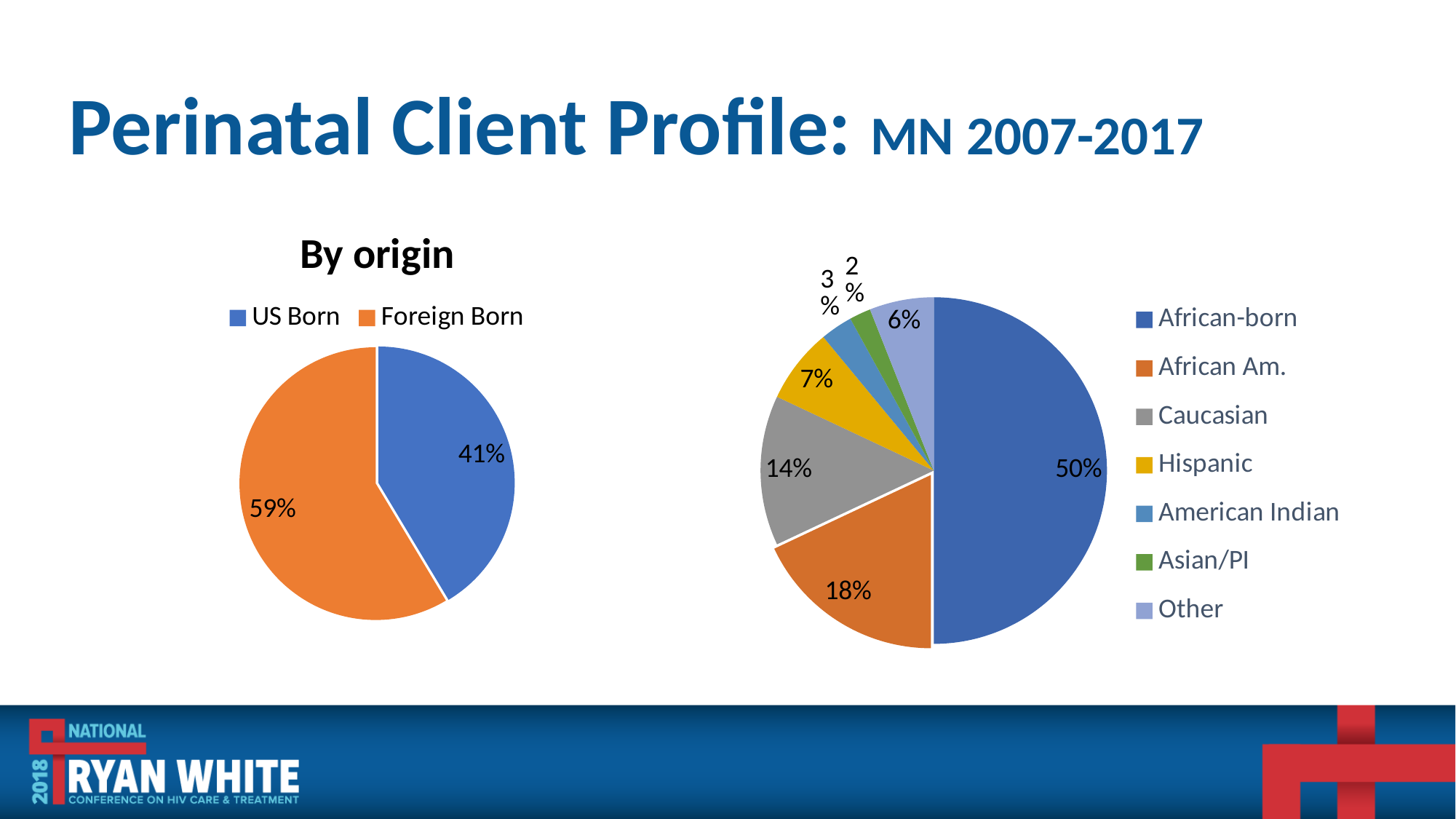
In the pie chart on the right, what is the difference between the African Am. and Other shares? 12% In the "By origin" chart, what share is Foreign Born? 59% In the "By origin" chart, what is the difference between the Foreign Born and US Born shares? 18% In the "By origin" chart, what share is US Born? 41% How many categories does the legend of the pie chart on the right list? 7 In the pie chart on the right, which category has the smallest share? Asian/PI In the "By origin" chart, which category has the larger share, US Born or Foreign Born? Foreign Born In the pie chart on the right, what share is Caucasian? 14% In the pie chart on the right, what share is Hispanic? 7% In the pie chart on the right, what share is African-born? 50% In the pie chart on the right, which category has the largest share? African-born What kind of chart is the "By origin" chart? Pie chart